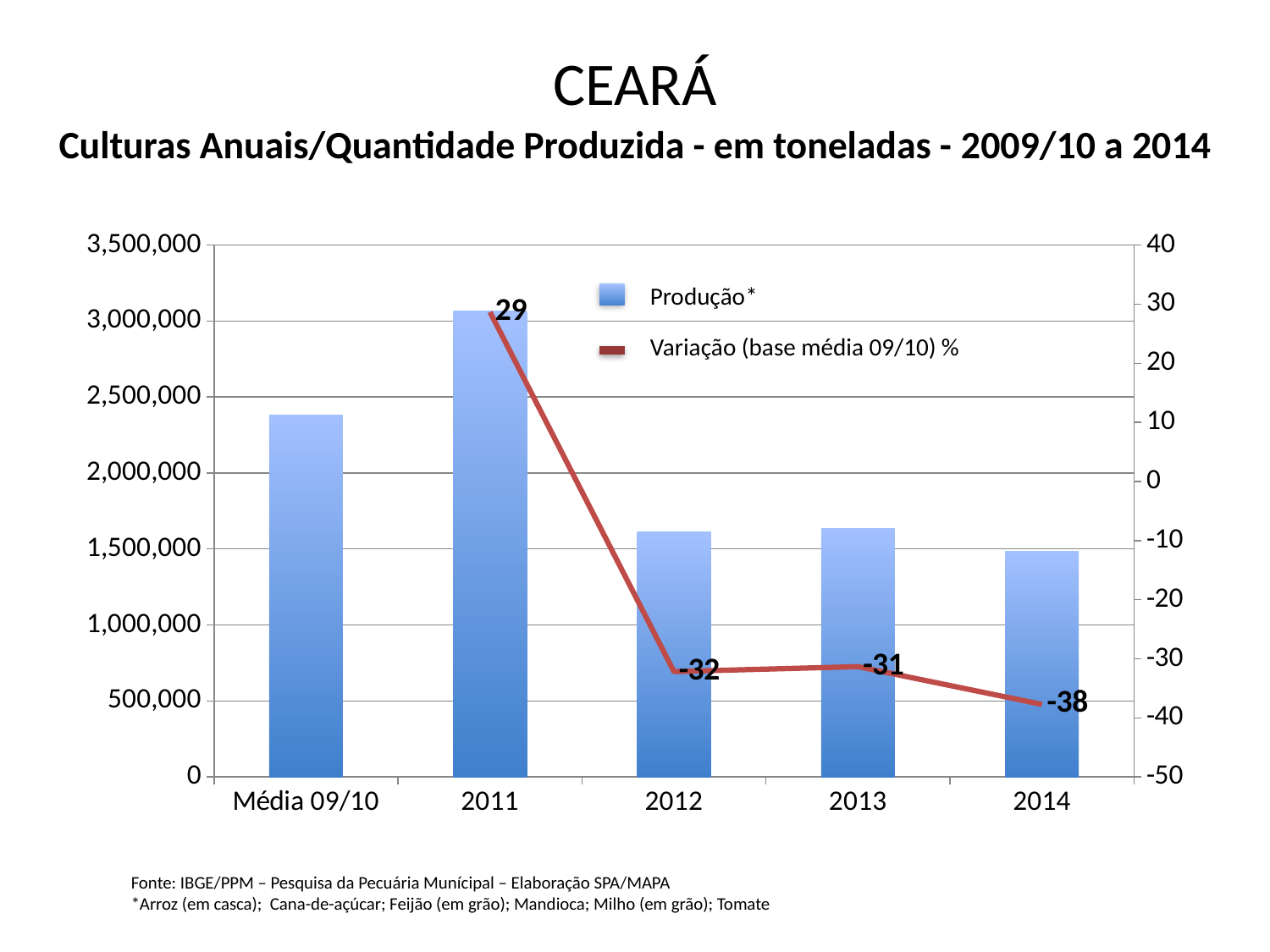
Which year has the lowest Variação (base média 09/10) % value? 2014 Is the Produção* value for Média 09/10 greater or less than 2,500,000? less What is the value of Variação (base média 09/10) % for 2012? -32 How many categories are shown on the x axis? 5 Which is larger, the Produção* bar for 2011 or for Média 09/10? 2011 Which year has the highest Produção* bar? 2011 What is the value of Variação (base média 09/10) % for 2011? 29 What is the difference between the Variação values for 2011 and 2014? 67 What is the value of Variação (base média 09/10) % for 2014? -38 Is the Produção* value for 2011 greater or less than 3,000,000? greater How many series does the legend list? 2 What kind of chart is shown on the slide? Combined bar and line chart